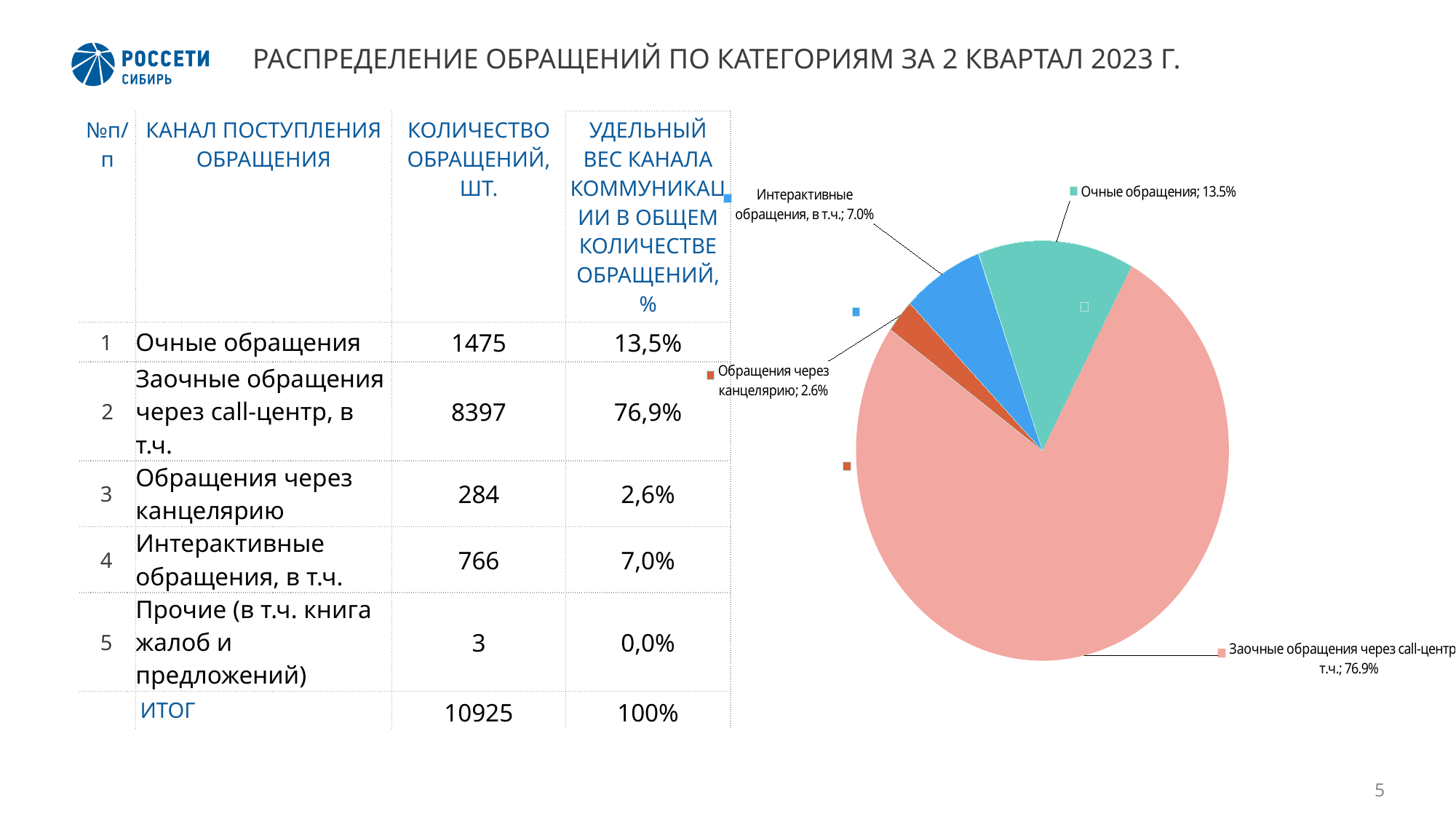
What colour is the "Очные обращения" slice? teal (green) What is the difference in percentage points between the "Очные обращения" slice and the "Интерактивные обращения, в т.ч." slice? 6.5 Which labelled category has the smallest slice of the pie? Обращения через канцелярию Which slice is larger: "Интерактивные обращения, в т.ч." or "Обращения через канцелярию"? Интерактивные обращения, в т.ч. Which category has the largest slice of the pie? Заочные обращения через call-центр, в т.ч. How many slices of the pie have a data label? 4 What kind of chart is shown on the slide? pie chart What share of the pie does "Заочные обращения через call-центр, в т.ч." have? 76.9% What share of the pie does "Обращения через канцелярию" have? 2.6% What share of the pie does "Очные обращения" have? 13.5% What colour is the largest slice of the pie? pink (salmon)